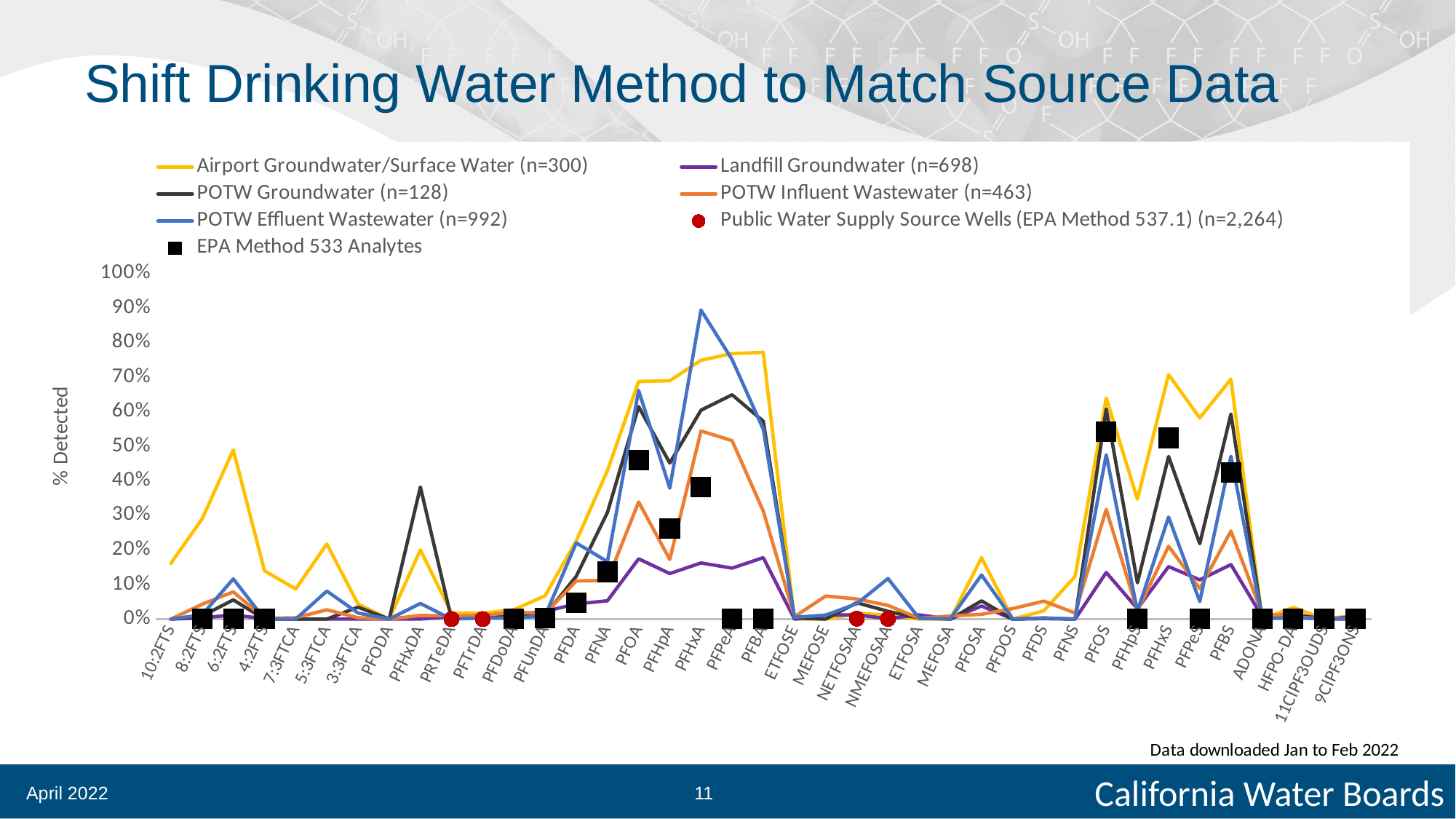
Which series has the lowest value at PFOA? Landfill Groundwater (n=698) Is the value for Airport Groundwater/Surface Water at PFBA greater or less than 70%? greater How many series does the legend list? 7 What sample size (n) is given in the legend for Landfill Groundwater? n=698 What kind of chart is shown on the slide? line chart Is the value for Landfill Groundwater at PFOA greater or less than 20%? less Is the value for POTW Groundwater at PFHxDA greater or less than 30%? greater Which series has the highest value at PFHxA? POTW Effluent Wastewater (n=992) What is the label on the vertical axis? % Detected At PFHxDA, which is larger: POTW Groundwater or Airport Groundwater/Surface Water? POTW Groundwater